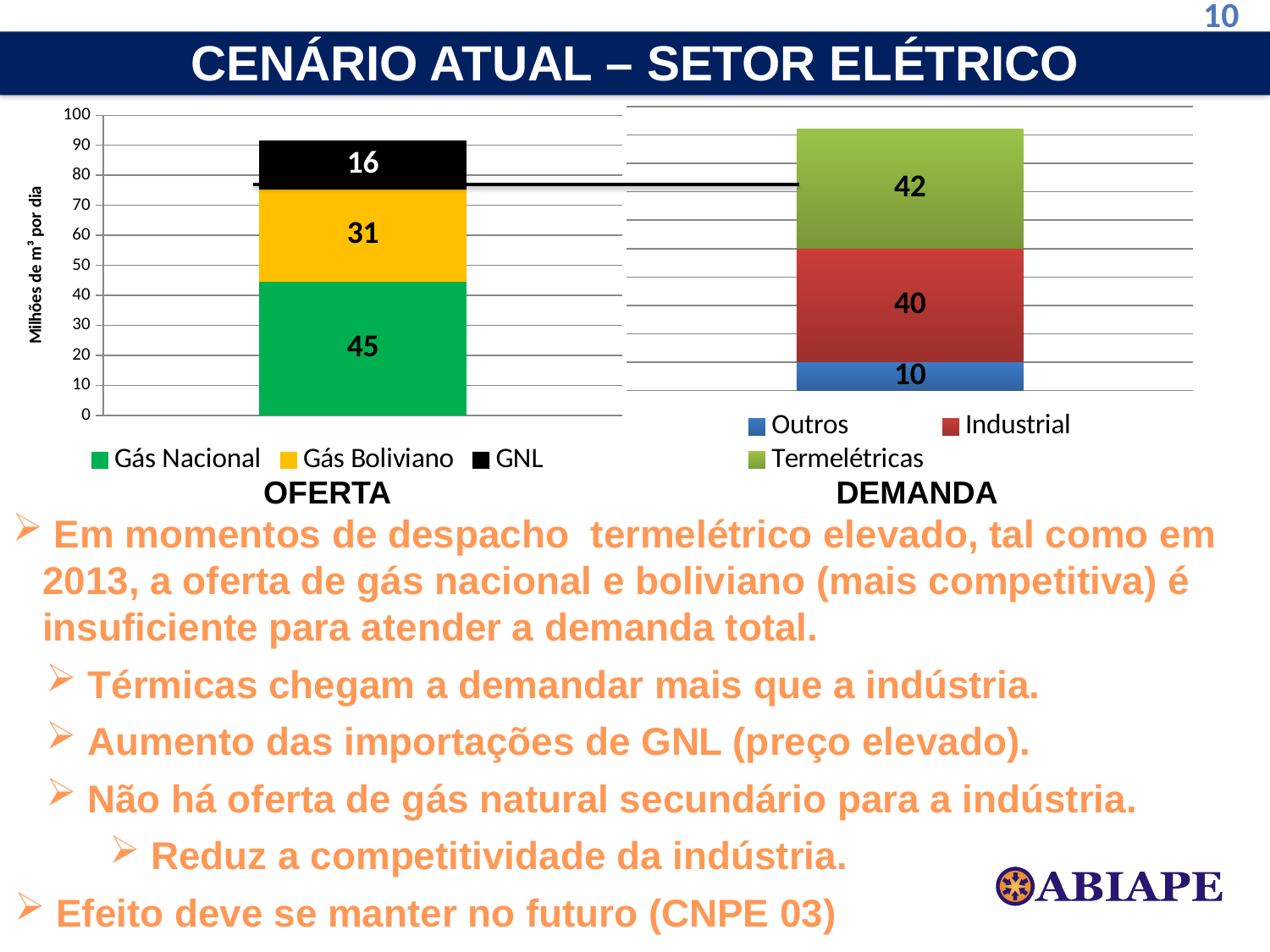
In the OFERTA chart, what is the difference between Gás Nacional and Gás Boliviano? 14 In the OFERTA chart, what is the value for GNL? 16 How many series does the legend of the DEMANDA chart list? 3 In the OFERTA chart, which series has the largest value? Gás Nacional What is the total of the stacked bar in the OFERTA chart? 92 In the OFERTA chart, what is the value for Gás Nacional? 45 In the DEMANDA chart, which series has the smallest value? Outros In the DEMANDA chart, what is the value for Termelétricas? 42 In the DEMANDA chart, what is the value for Outros? 10 What is the total of the stacked bar in the DEMANDA chart? 92 In the DEMANDA chart, which is larger, Termelétricas or Industrial? Termelétricas What type of chart is the OFERTA chart? Stacked bar chart